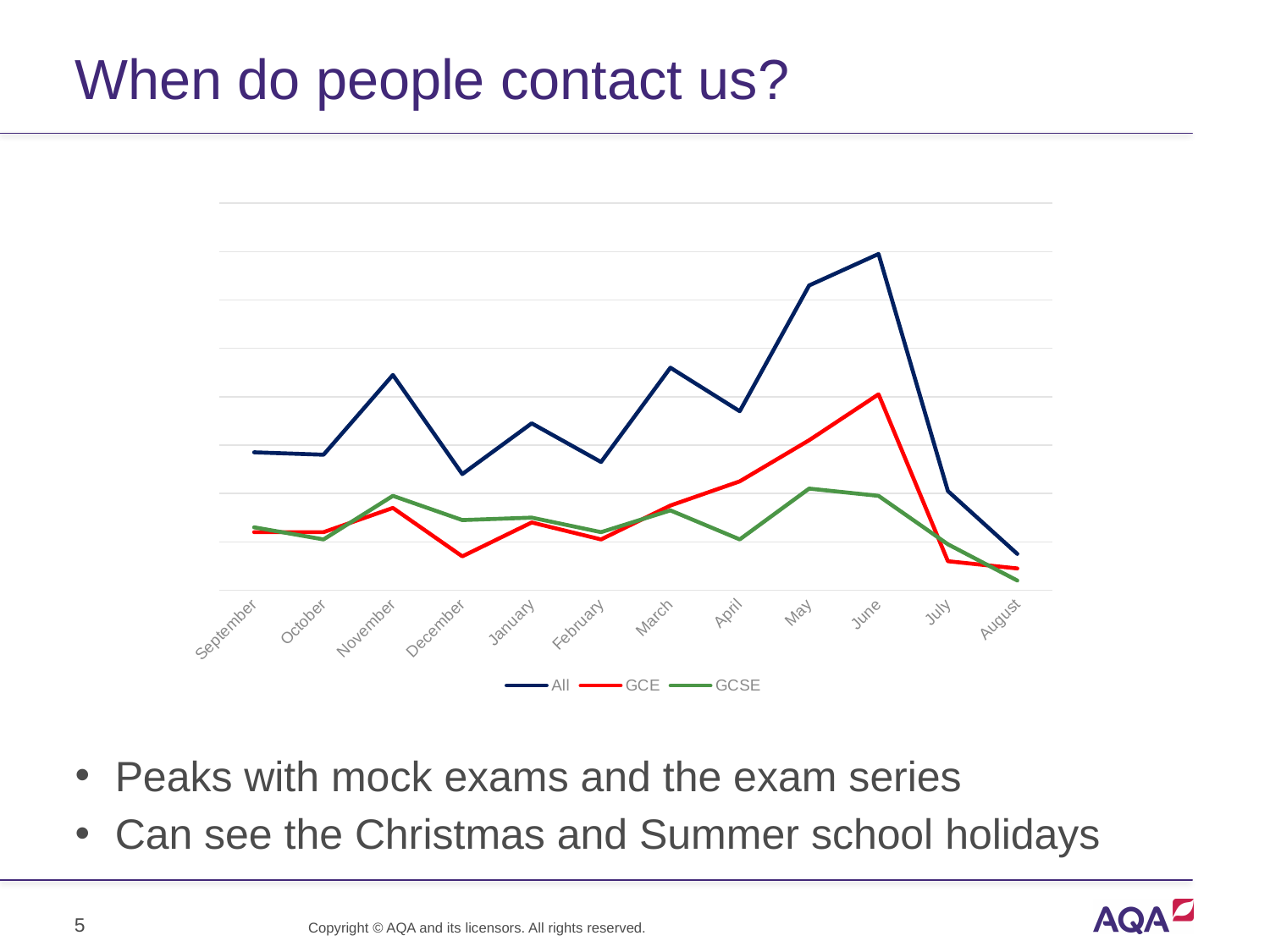
In December, which is larger, the GCE value or the GCSE value? GCSE In which month is the GCSE series at its lowest? August Does the GCE series rise or fall from February to June? Rise In which month does the GCE series reach its highest value? June How many months are plotted along the x axis? 12 Does the All series rise or fall from June to August? Fall In which month is the All series at its lowest? August In which month does the All series reach its highest value? June How many series does the legend list? 3 In June, which is larger, the GCE value or the GCSE value? GCE What are the three entries in the chart legend? All, GCE, GCSE What kind of chart is shown on the slide? Line chart